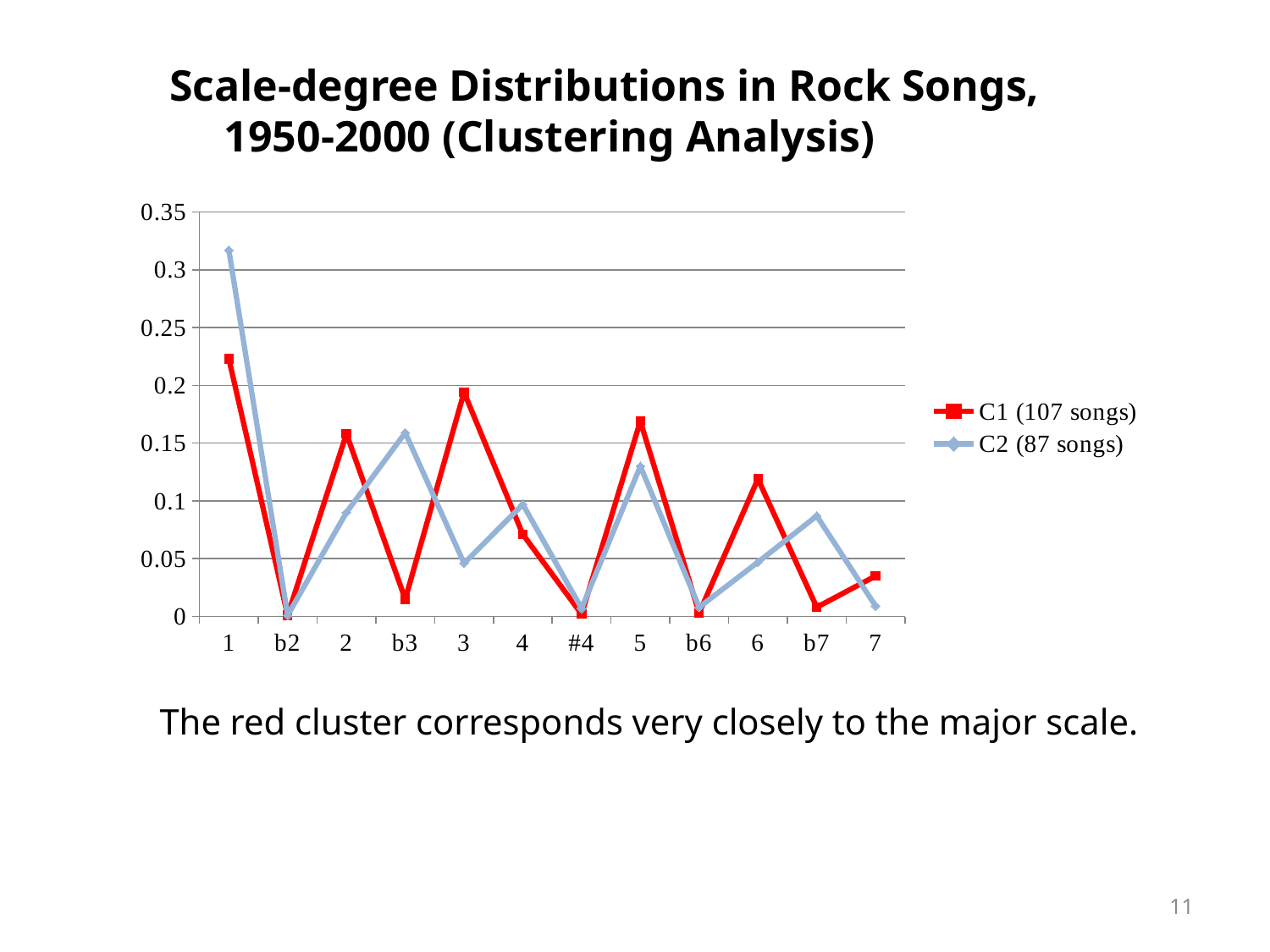
What kind of chart is shown on the slide? line chart At scale degree b3, which series has the larger value, C1 (107 songs) or C2 (87 songs)? C2 (87 songs) How many series does the legend list? 2 Which scale degree has the highest value for the C2 (87 songs) series? 1 Is the value for C2 (87 songs) at scale degree 1 greater or less than 0.3? greater At scale degree 2, which series has the larger value, C1 (107 songs) or C2 (87 songs)? C1 (107 songs) Which scale degree has the highest value for the C1 (107 songs) series? 1 Which colour is used for the C1 (107 songs) series? red How many scale-degree categories are shown on the x axis? 12 Is the value for C1 (107 songs) at scale degree 6 greater or less than 0.1? greater